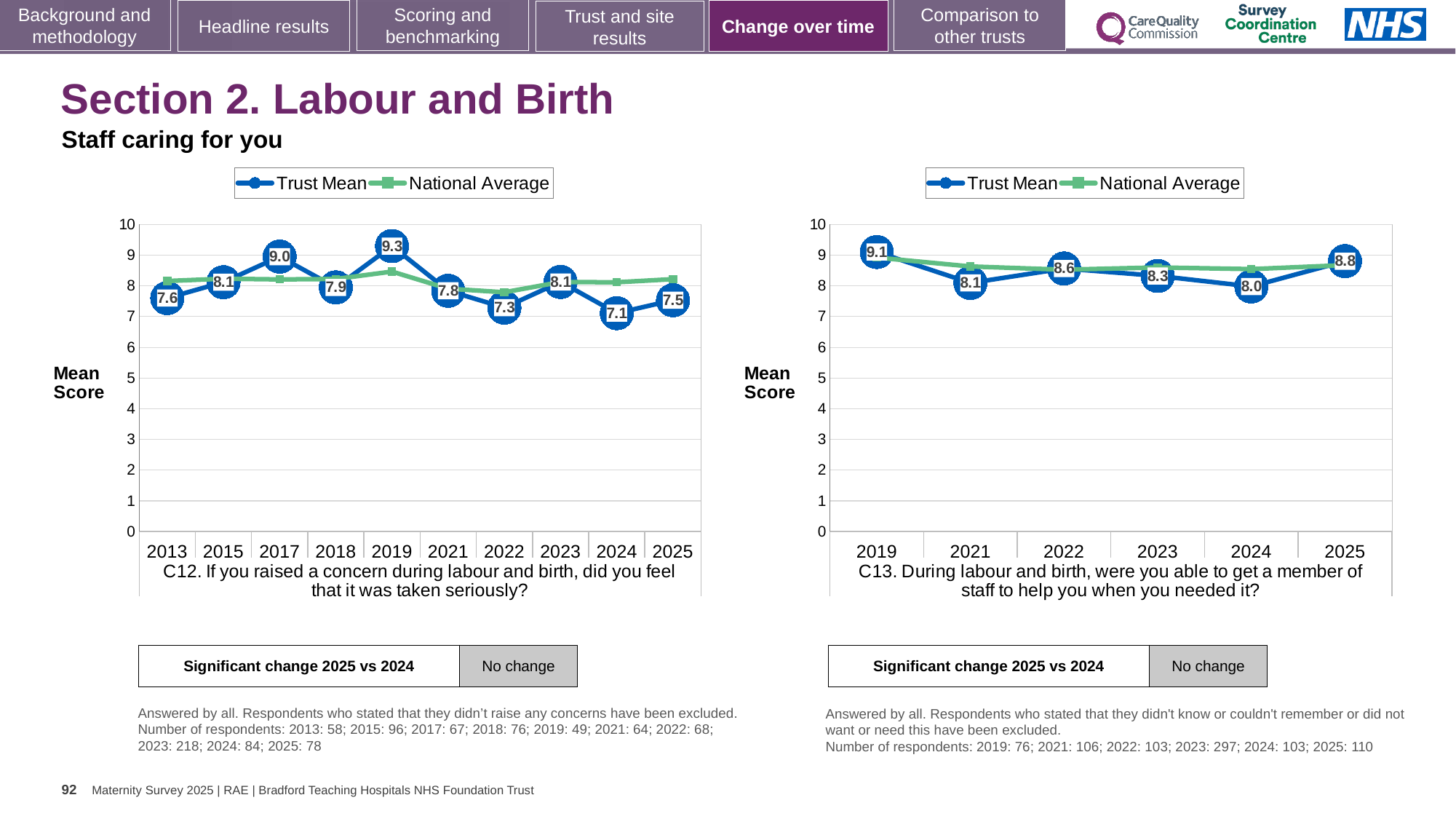
In the C12 chart (left), which year has the lowest Trust Mean? 2024 In the C13 chart (right), is the Trust Mean for 2025 larger or smaller than for 2024? larger In the C12 chart (left), what is the Trust Mean for 2019? 9.3 What type of chart is the C13 chart (right)? Line chart In the C13 chart (right), what is the difference between the Trust Mean for 2019 and 2021? 1.0 In the C13 chart (right), which year has the lowest Trust Mean? 2024 In the C12 chart (left), what is the Trust Mean for 2025? 7.5 In the C13 chart (right), what is the Trust Mean for 2019? 9.1 In the C12 chart (left), which year has the highest Trust Mean? 2019 In the C12 chart (left), what is the difference between the Trust Mean for 2019 and 2024? 2.2 In the C13 chart (right), how many series does the legend list? 2 In the C12 chart (left), how many years are plotted on the x axis? 10